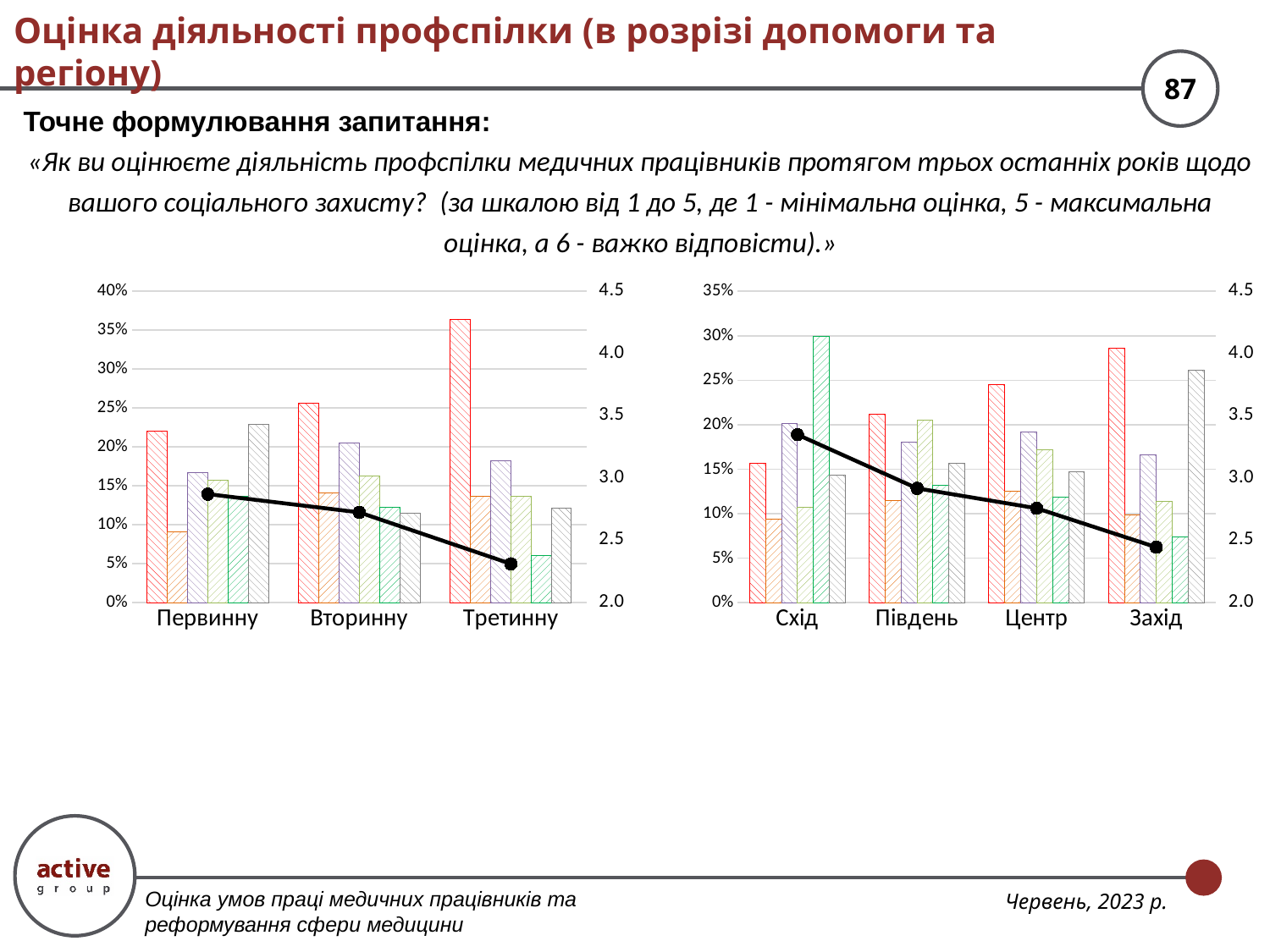
On the left chart, which category has the highest value on the black line? Первинну On the right chart, does the black line rise or fall from Схід to Захід? Falls On the right chart, is the black line value for Схід greater or less than 3.0? greater On the right chart, how many categories are shown on the x axis? 4 On the left chart, how many categories are shown on the x axis? 3 On the left chart, is the black line value for Третинну greater or less than 2.5? less On the left chart, does the black line rise or fall from Первинну to Третинну? Falls On the right chart, which category has the lowest value on the black line? Захід On the left chart, which category has the lowest value on the black line? Третинну What kind of chart is the left chart? Bar chart with a line On the right chart, which category has the highest value on the black line? Схід On the right chart, is the black line value for Схід larger or smaller than the value for Захід? larger